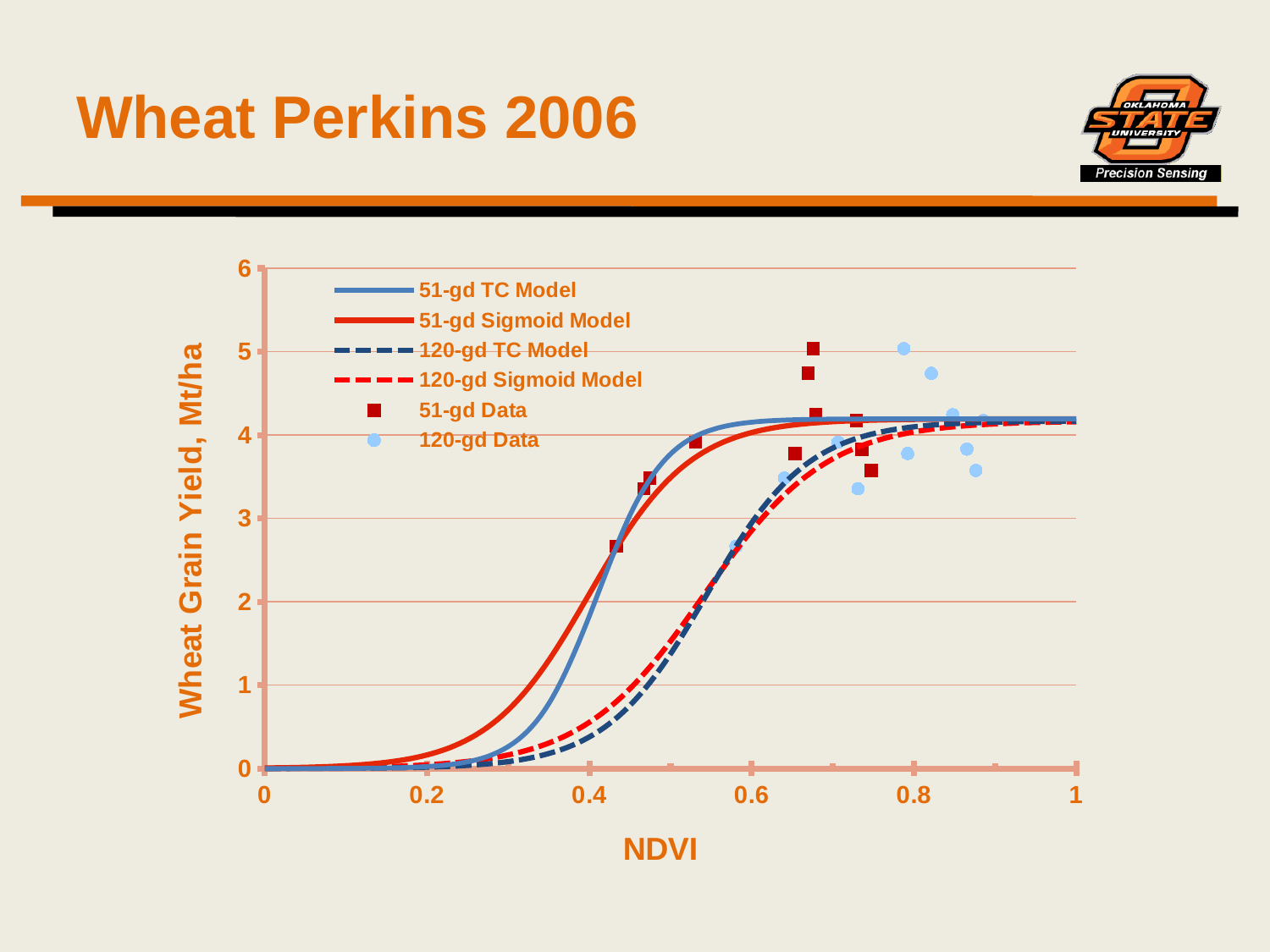
What kind of chart is shown on the slide? line chart Do the model curves rise or fall as NDVI increases along the x axis? rise Is the value of the 120-gd TC Model at NDVI 0.4 greater or less than 1? less What is the label of the y axis? Wheat Grain Yield, Mt/ha What is the title of the slide containing the chart? Wheat Perkins 2006 At NDVI 0.3, which is higher, the 51-gd Sigmoid Model or the 51-gd TC Model? 51-gd Sigmoid Model At NDVI 0.4, which is higher, the 51-gd TC Model or the 120-gd TC Model? 51-gd TC Model Is the value of the 51-gd Sigmoid Model at NDVI 0.2 greater or less than 1? less Is the value of the 120-gd Sigmoid Model at NDVI 0.8 greater or less than 3? greater How many series does the legend list? 6